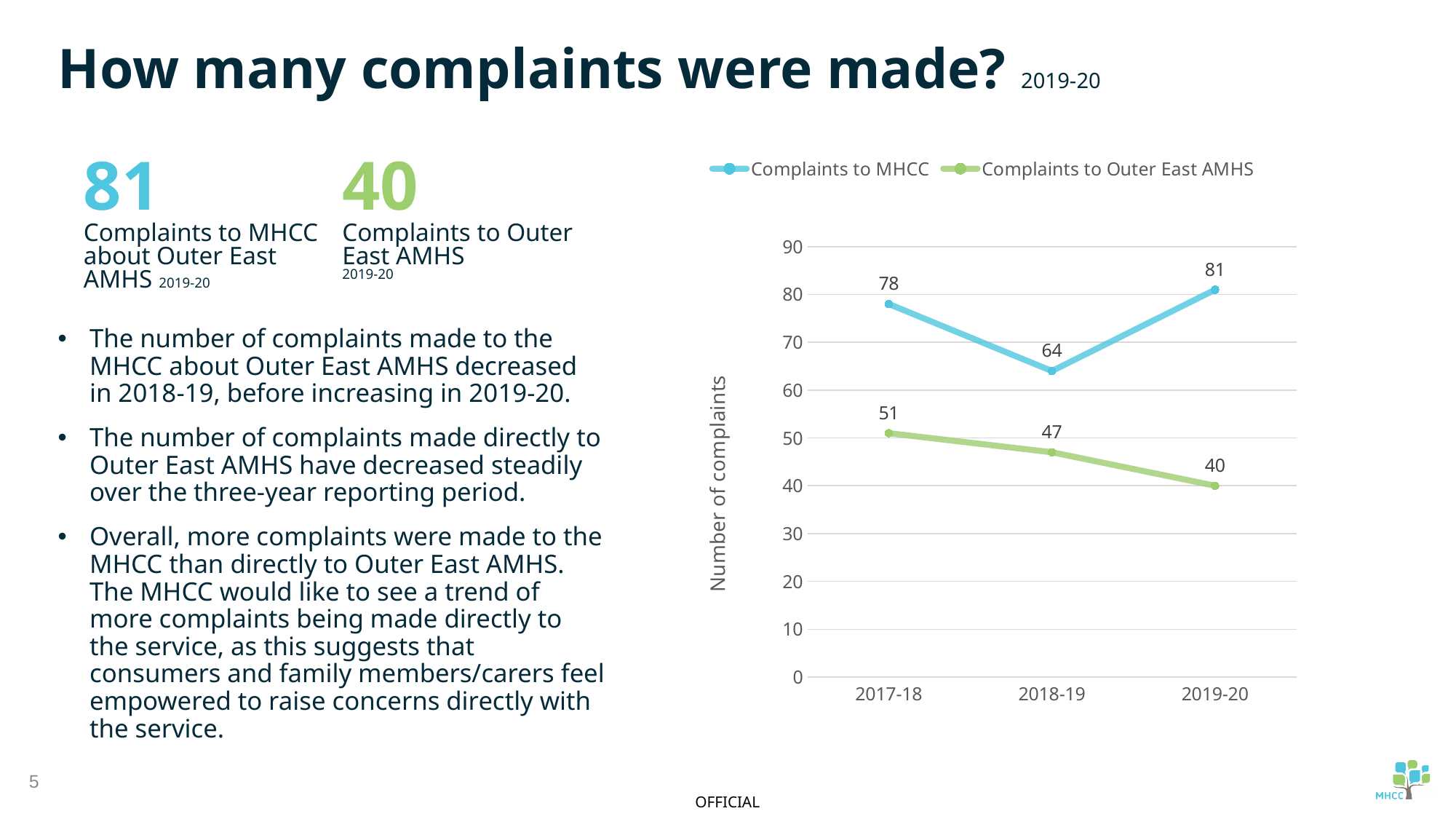
In which year were complaints to Outer East AMHS lowest? 2019-20 How many years are plotted on the x axis of the chart? 3 What type of chart is shown on the slide? Line chart What is the label on the vertical axis of the chart? Number of complaints What is the difference between complaints to MHCC and complaints to Outer East AMHS in 2019-20? 41 What was the number of complaints to Outer East AMHS in 2017-18? 51 Do complaints to Outer East AMHS rise or fall from 2017-18 to 2019-20? Fall How many series does the chart legend list? 2 In which year were complaints to MHCC highest? 2019-20 Which series had more complaints in 2017-18, Complaints to MHCC or Complaints to Outer East AMHS? Complaints to MHCC What was the number of complaints to Outer East AMHS in 2019-20? 40 What was the number of complaints to MHCC in 2018-19? 64